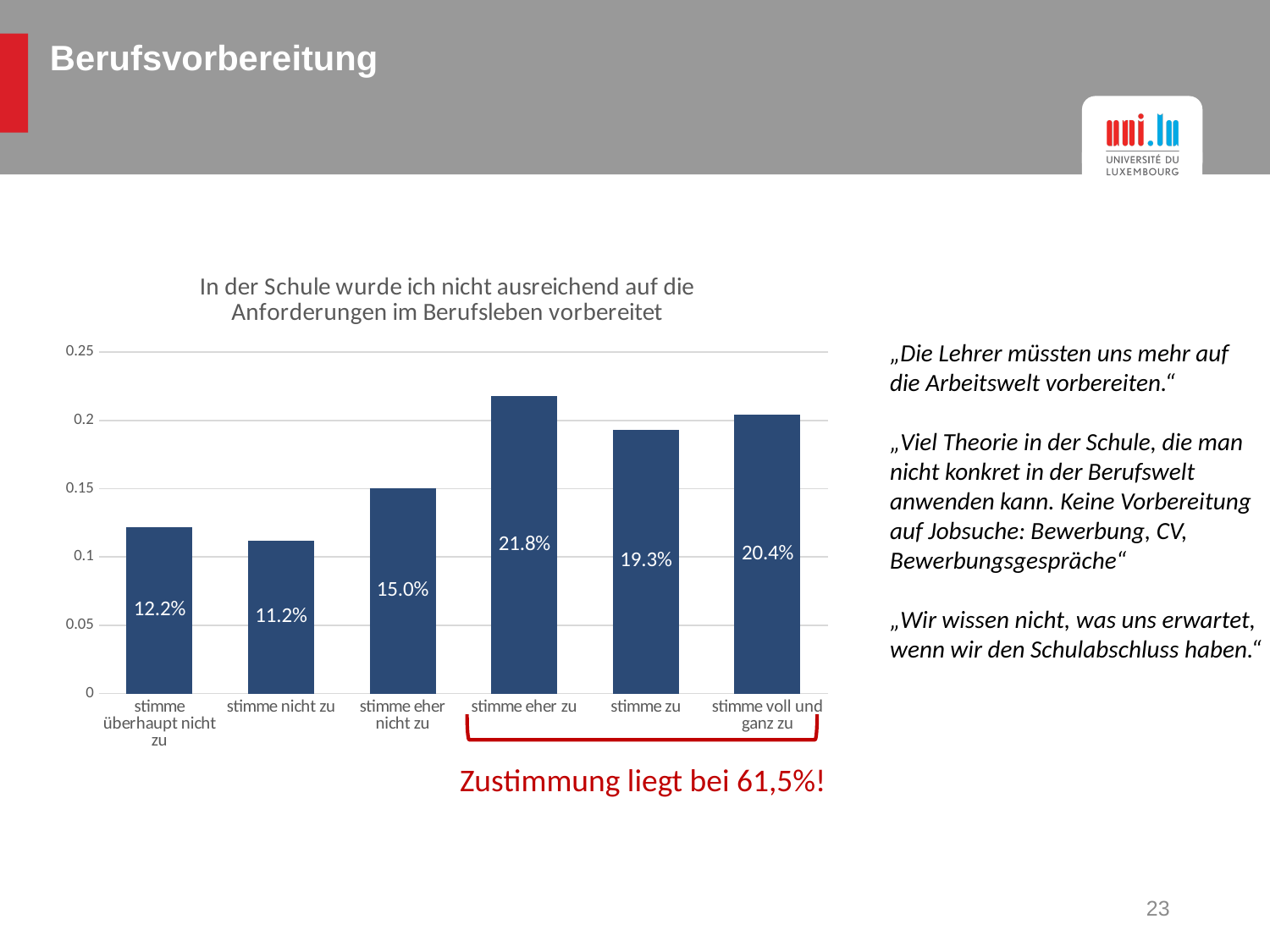
What is the value for "stimme eher zu"? 21.8% What kind of chart is shown? bar chart What is the total of the three agreement categories (stimme eher zu, stimme zu, stimme voll und ganz zu)? 61.5% What is the value for "stimme nicht zu"? 11.2% Which category has the highest value? stimme eher zu What is the title of the chart? In der Schule wurde ich nicht ausreichend auf die Anforderungen im Berufsleben vorbereitet Which is larger, "stimme überhaupt nicht zu" or "stimme eher nicht zu"? stimme eher nicht zu Which category has the lowest value? stimme nicht zu What is the value for "stimme voll und ganz zu"? 20.4% What is the difference between "stimme eher zu" and "stimme zu"? 2.5% How many categories are shown on the x axis? 6 Is the value for "stimme zu" greater or less than 0.15? greater